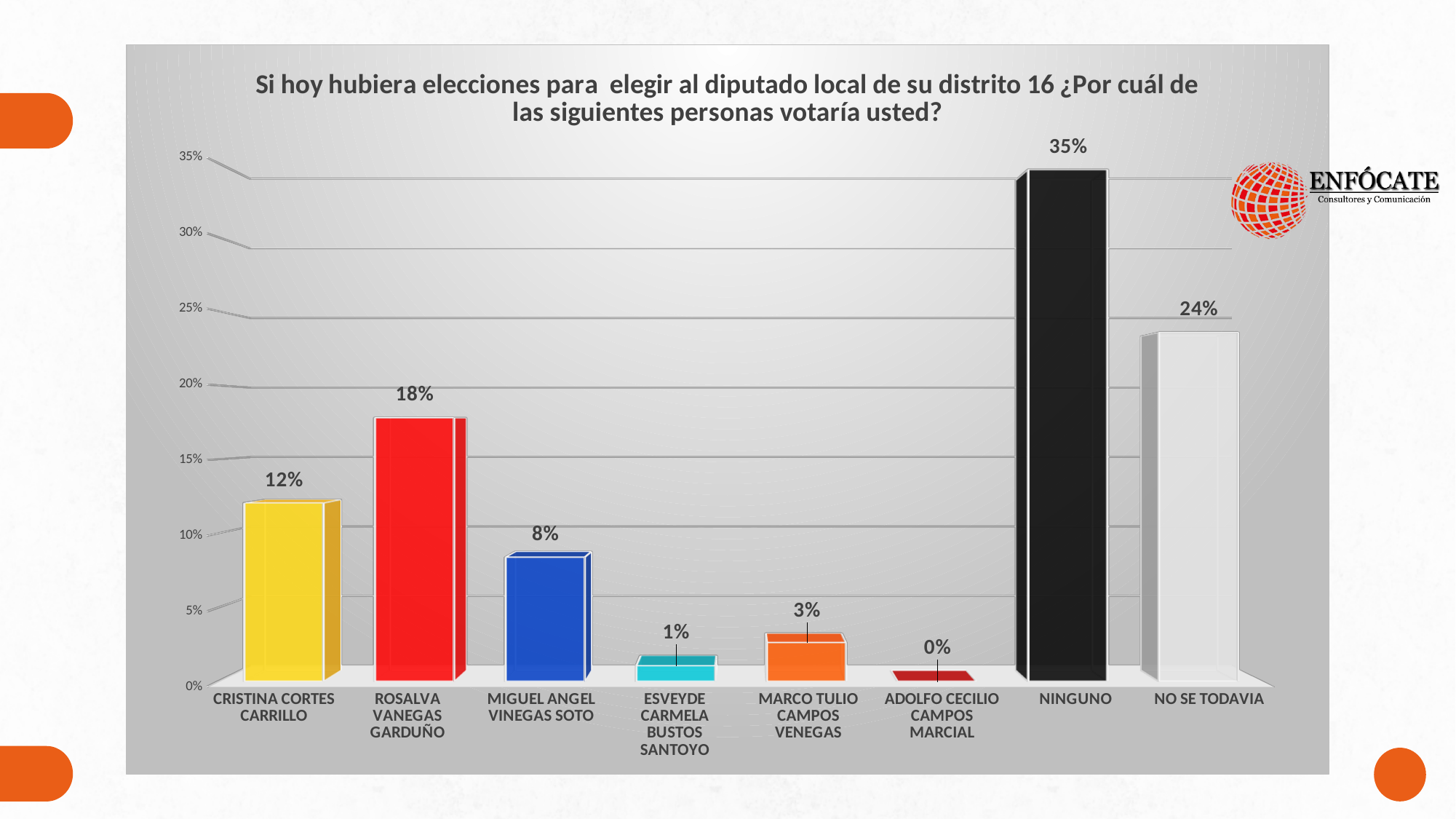
What is the difference between the values for Cristina Cortes Carrillo and Marco Tulio Campos Venegas? 9% Which category has the highest value in the chart? NINGUNO What colour is the bar for NINGUNO? Black What type of chart is shown on the slide? Bar chart How many categories are shown on the x axis of the chart? 8 What percentage of respondents said they would vote for Rosalva Vanegas Garduño? 18% Which has a larger value, Cristina Cortes Carrillo or Rosalva Vanegas Garduño? Rosalva Vanegas Garduño Which category has the lowest value in the chart? ADOLFO CECILIO CAMPOS MARCIAL What is the difference between the values for NINGUNO and NO SE TODAVIA? 11% What value is shown for Miguel Angel Vinegas Soto? 8% What percentage is shown for the 'NO SE TODAVIA' category? 24% Is the value for Rosalva Vanegas Garduño greater or less than 15%? greater